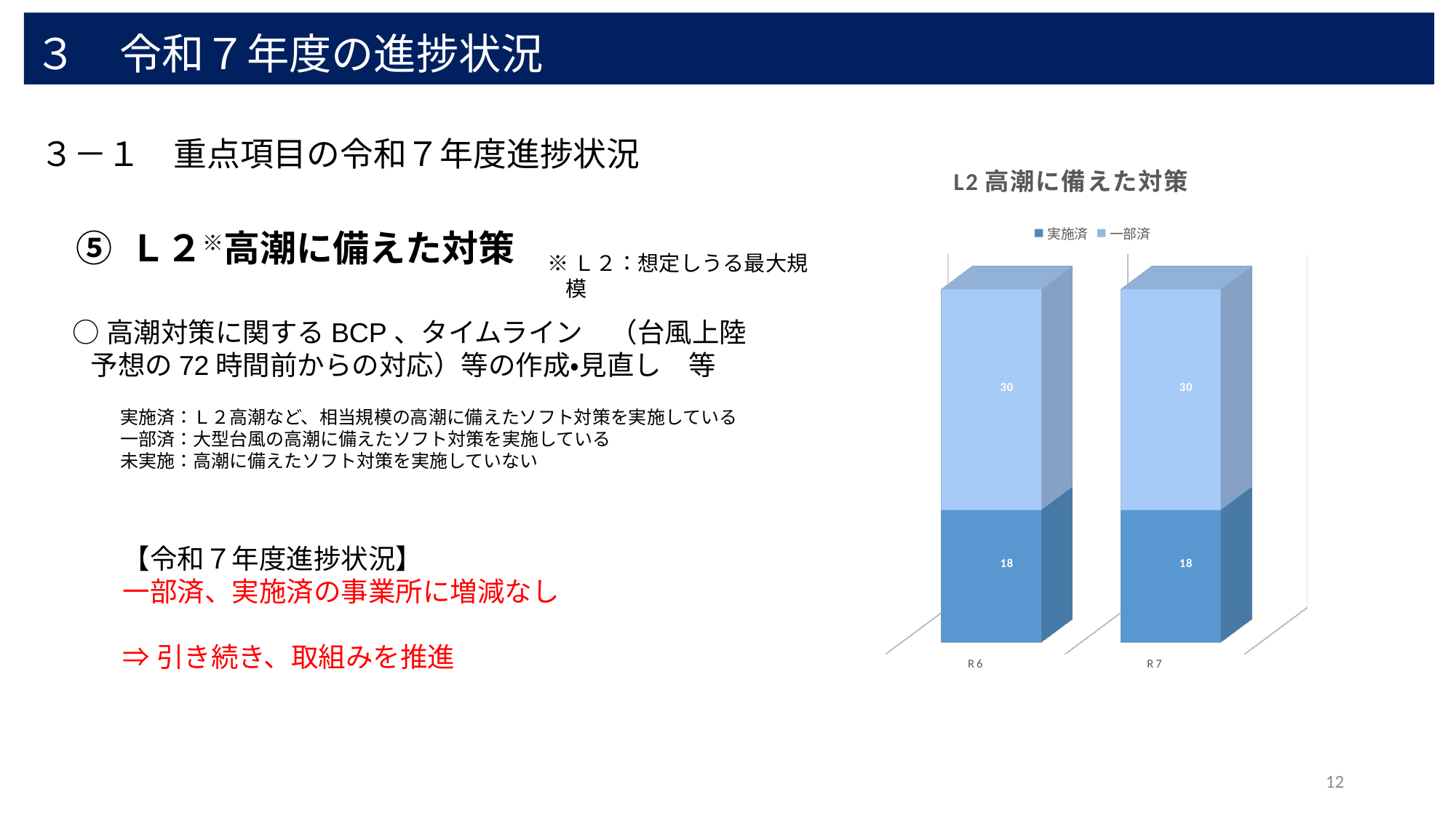
What is the title of the chart? L2 高潮に備えた対策 Which series does the legend list? 実施済, 一部済 How many categories are shown on the x axis? 2 What is the value of 一部済 for R6? 30 How many series does the legend list? 2 Which is larger for R6, 実施済 or 一部済? 一部済 What is the value of 実施済 for R7? 18 What is the value of 実施済 for R6? 18 What is the total of the stacked bar for R6? 48 What kind of chart is shown on the slide? Stacked bar chart What is the difference between 一部済 and 実施済 for R7? 12 What is the value of 一部済 for R7? 30